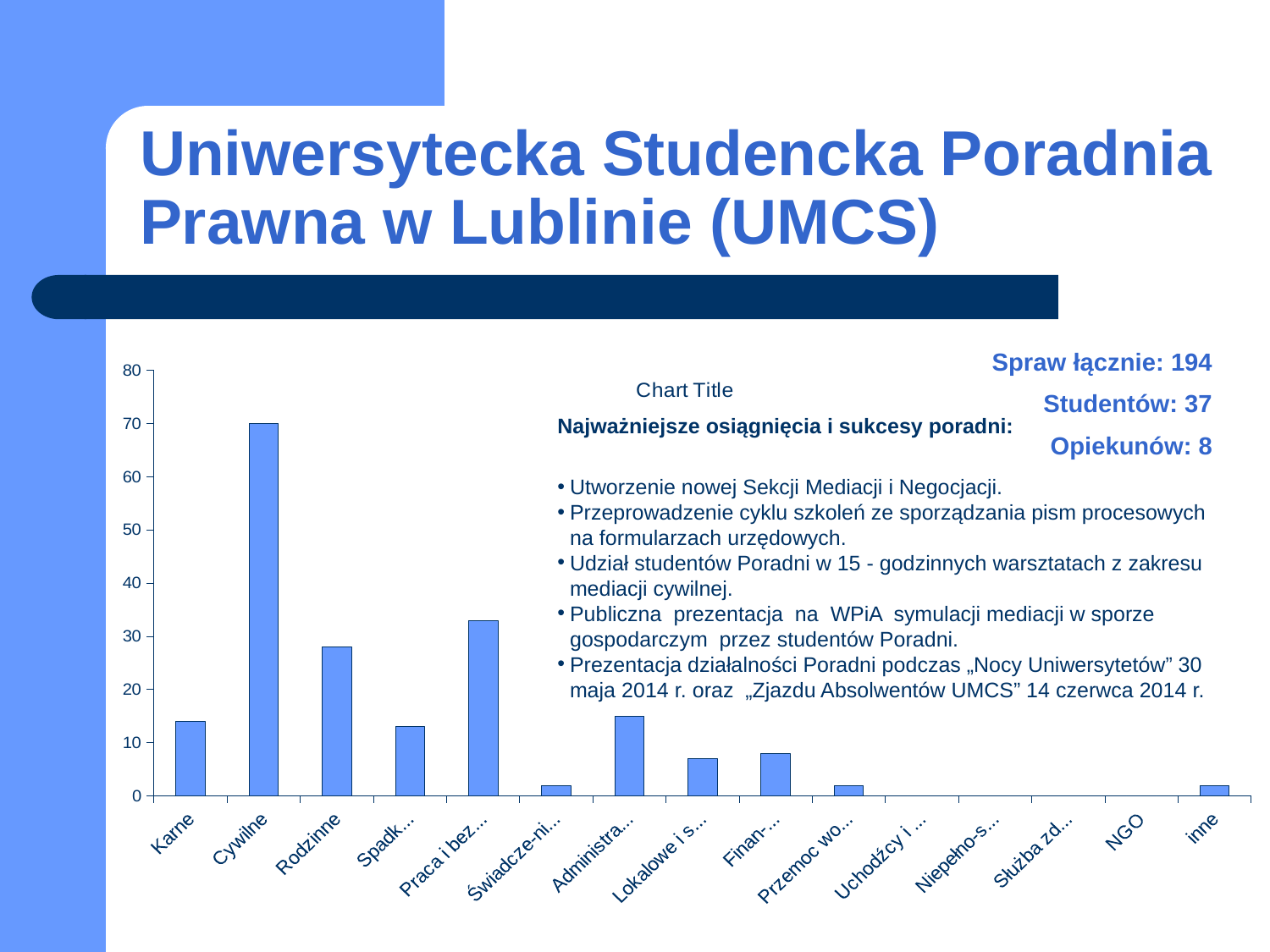
What is the title shown on the chart? Chart Title Is the value for Karne greater or less than 20? less What kind of chart is shown on the slide? bar chart What is the value for Cywilne in the chart? 70 Is the value for Karne greater or less than 10? greater Which is larger, the value for Cywilne or the value for Rodzinne? Cywilne How many categories are shown on the x axis of the chart? 15 Which category has the highest bar in the chart? Cywilne Is the value for Rodzinne greater or less than 20? greater Which is larger, the value for Praca i bez... or the value for Rodzinne? Praca i bez...